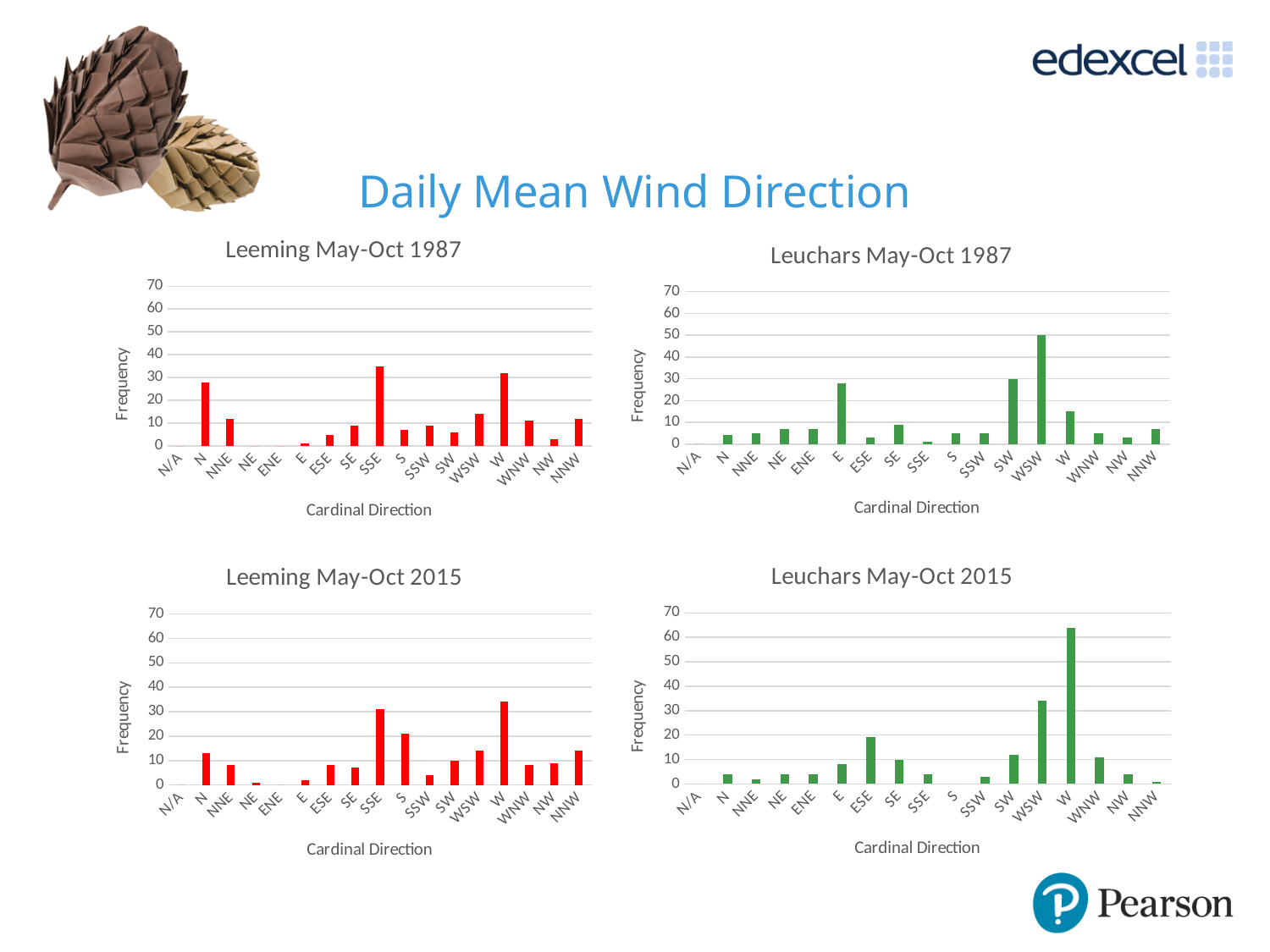
In the 'Leuchars May-Oct 1987' chart, which cardinal direction has the highest frequency? WSW In the 'Leeming May-Oct 1987' chart, which has the higher frequency, N or NNE? N In the 'Leuchars May-Oct 2015' chart, is the value for W greater or less than 60? greater In the 'Leeming May-Oct 1987' chart, is the value for N greater or less than 20? greater What is the y-axis title of the 'Leuchars May-Oct 2015' chart? Frequency In the 'Leuchars May-Oct 1987' chart, is the value for E greater or less than 20? greater In the 'Leuchars May-Oct 2015' chart, which has the higher frequency, W or WSW? W In the 'Leuchars May-Oct 2015' chart, which cardinal direction has the highest frequency? W How many cardinal direction categories are shown on the x axis of the 'Leeming May-Oct 2015' chart? 17 In the 'Leuchars May-Oct 1987' chart, what is the frequency for WSW? 50 What type of chart is the 'Leeming May-Oct 1987' chart? bar chart